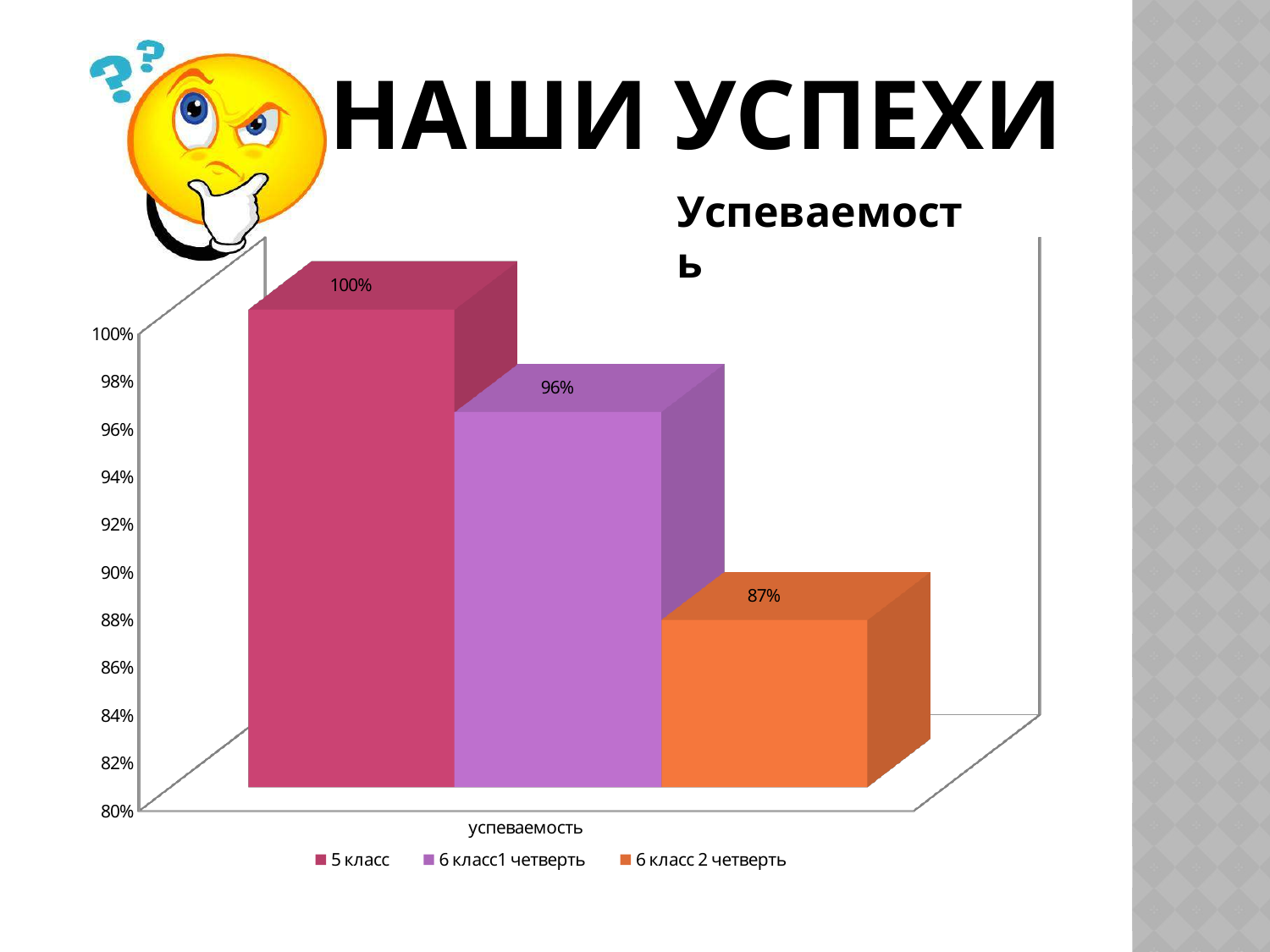
Which is larger, the value for 5 класс or the value for 6 класс1 четверть? 5 класс What is the title of the chart? Успеваемость What is the value for 6 класс1 четверть? 96% Which series has the lowest value? 6 класс 2 четверть What is the value for 6 класс 2 четверть? 87% What kind of chart is shown on the slide? bar chart What is the difference between the values for 6 класс1 четверть and 6 класс 2 четверть? 9% How many series does the legend list? 3 What is the difference between the values for 5 класс and 6 класс 2 четверть? 13% Is the value for 6 класс 2 четверть greater or less than 90%? less What is the value for 5 класс? 100% Which series has the highest value? 5 класс